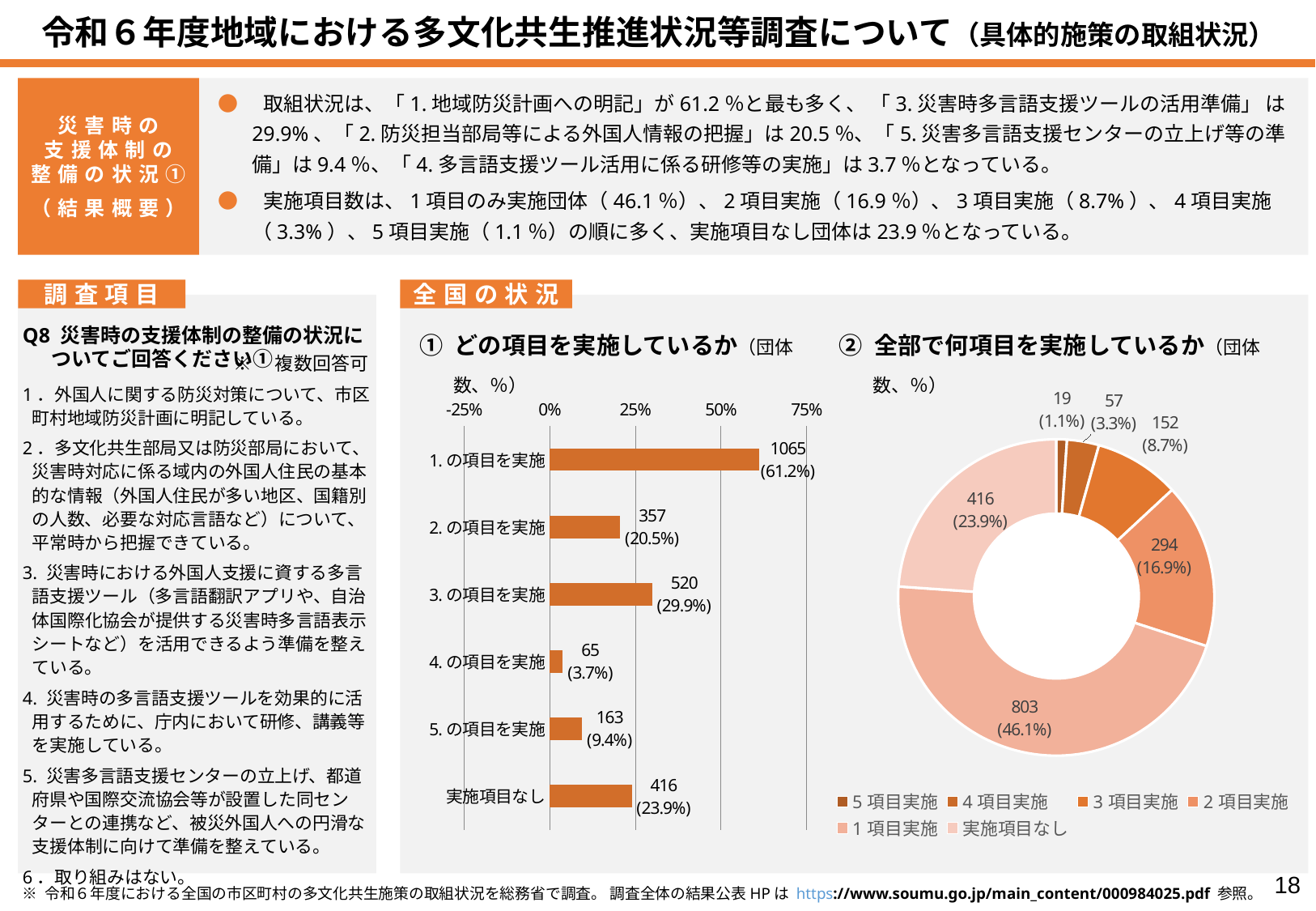
「② 全部で何項目を実施しているか」のグラフで、最も割合が小さい区分はどれですか？ 5項目実施 「① どの項目を実施しているか」のグラフには、いくつの項目（カテゴリ）がありますか？ 6 「① どの項目を実施しているか」のグラフで、「3.の項目を実施」の割合は何%ですか？ 29.9% 「① どの項目を実施しているか」のグラフで、「1.の項目を実施」の団体数はいくつですか？ 1065 「① どの項目を実施しているか」のグラフで、「5.の項目を実施」と「実施項目なし」ではどちらの団体数が多いですか？ 実施項目なし 「① どの項目を実施しているか」のグラフで、最も団体数が多い項目はどれですか？ 1.の項目を実施 「② 全部で何項目を実施しているか」のグラフの凡例には、いくつの区分が示されていますか？ 6 「② 全部で何項目を実施しているか」のグラフで、「1項目実施」の団体数はいくつですか？ 803 「② 全部で何項目を実施しているか」のグラフで、「2項目実施」の割合は何%ですか？ 16.9% 「① どの項目を実施しているか」のグラフで、「3.の項目を実施」と「2.の項目を実施」の団体数の差はいくつですか？ 163 「① どの項目を実施しているか」のグラフは何種類のグラフですか？ 棒グラフ 「① どの項目を実施しているか」のグラフで、最も団体数が少ない項目はどれですか？ 4.の項目を実施